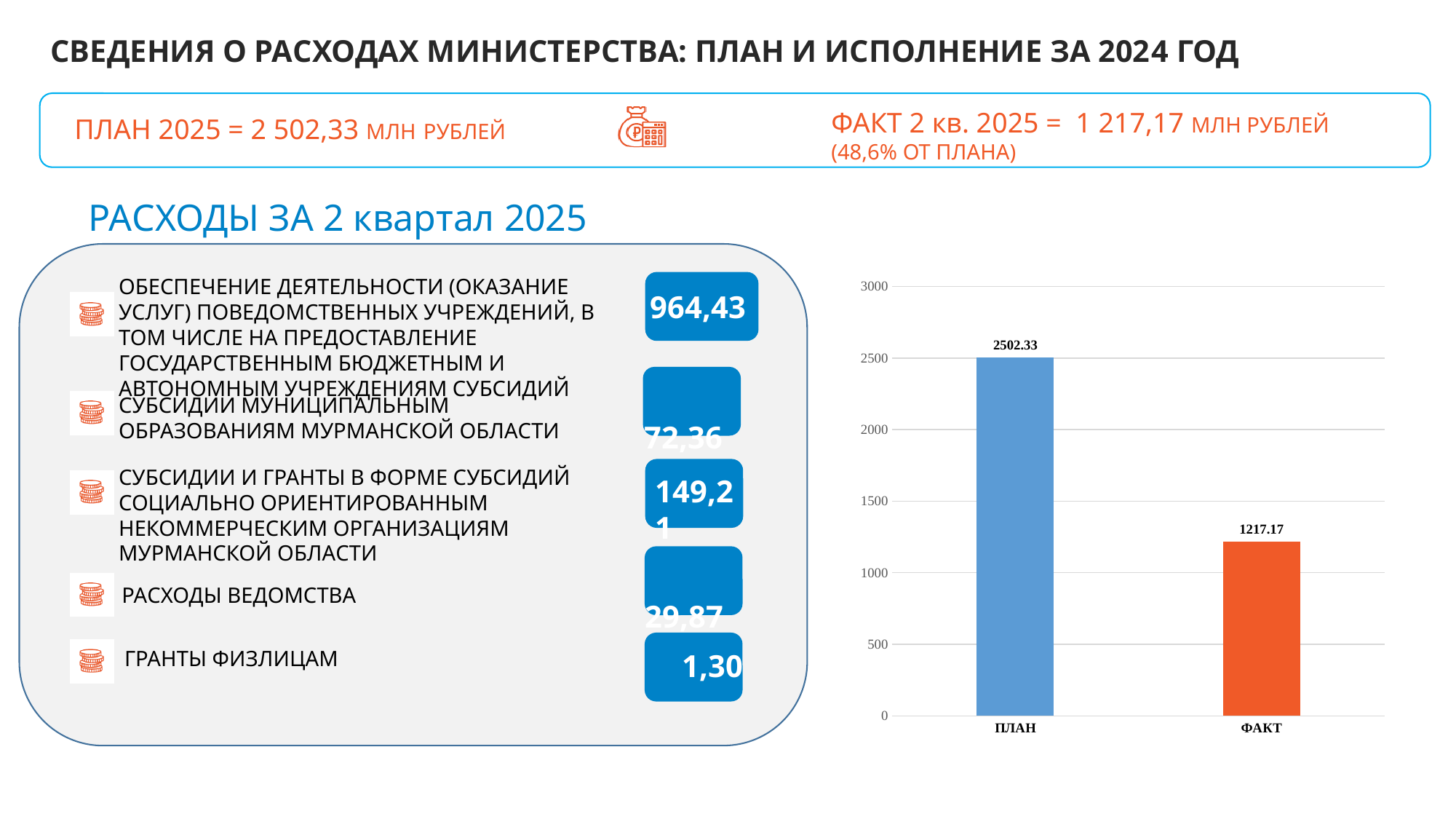
What colour is the ФАКТ bar in the chart? orange Which category has the lowest bar in the chart? ФАКТ How many bars are plotted in the chart? 2 What kind of chart is shown on the right side of the slide? bar chart What is the highest tick value shown on the vertical axis of the chart? 3000 What is the value of the ПЛАН bar in the chart? 2502.33 What is the difference between the ПЛАН and ФАКТ values in the chart? 1285.16 Which category has the highest bar in the chart? ПЛАН Which is larger in the chart, ПЛАН or ФАКТ? ПЛАН Is the value for ФАКТ greater or less than 1500? less Is the value for ПЛАН greater or less than 2000? greater What is the value of the ФАКТ bar in the chart? 1217.17